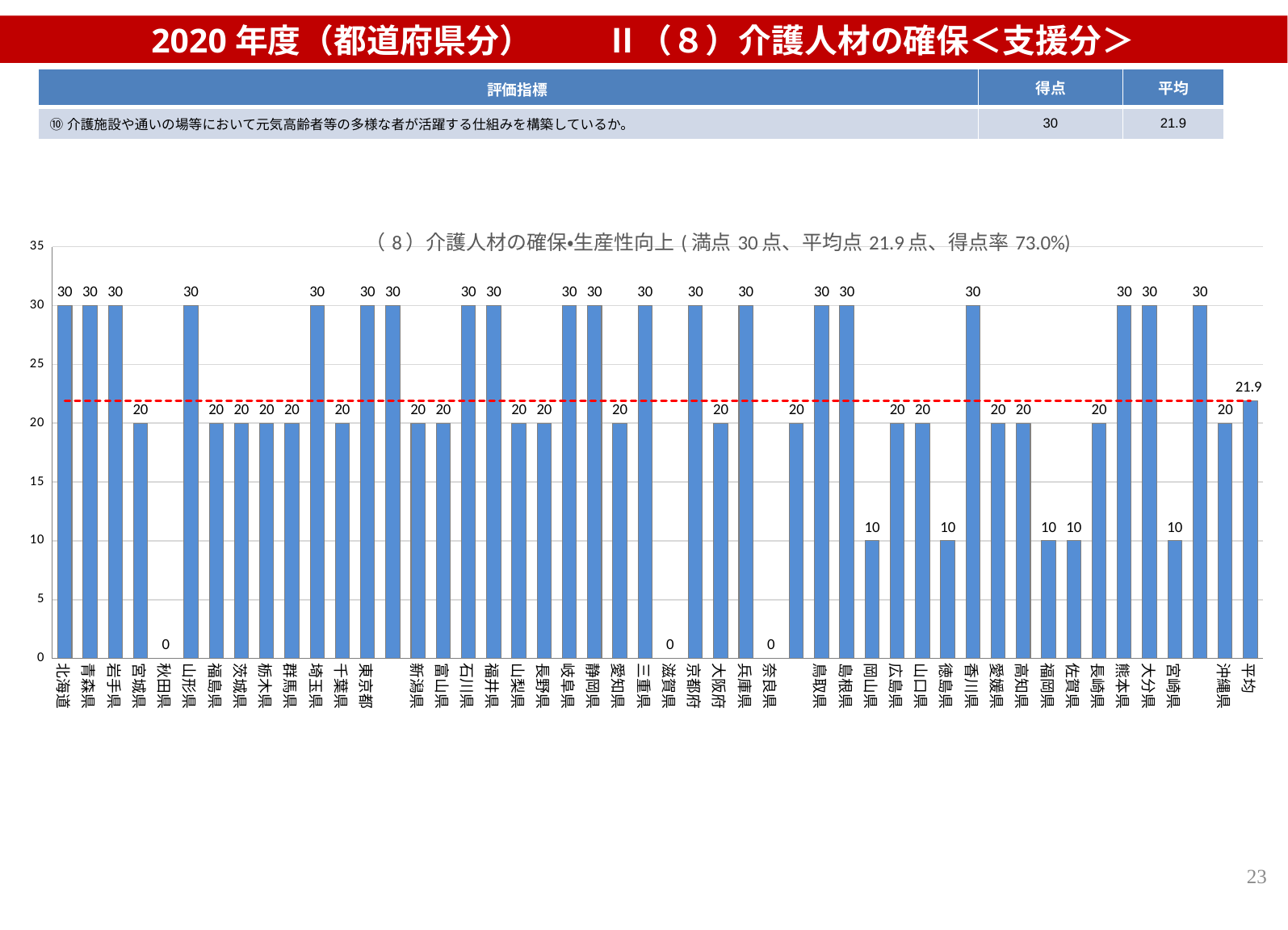
What value does the red dashed horizontal line mark? 21.9 What is the value for 平均? 21.9 What is the value for 秋田県? 0 What is the value for 沖縄県? 20 What is the difference between the values for 北海道 and 宮崎県? 20 Is the value for 熊本県 greater or less than 25? greater What is the difference between the values for 香川県 and 愛媛県? 10 What kind of chart is shown on the slide? bar chart What is the highest value shown on the chart? 30 Which is larger, the value for 徳島県 or the value for 広島県? 広島県 What is the value for 岡山県? 10 Is the value for 福岡県 greater or less than 15? less